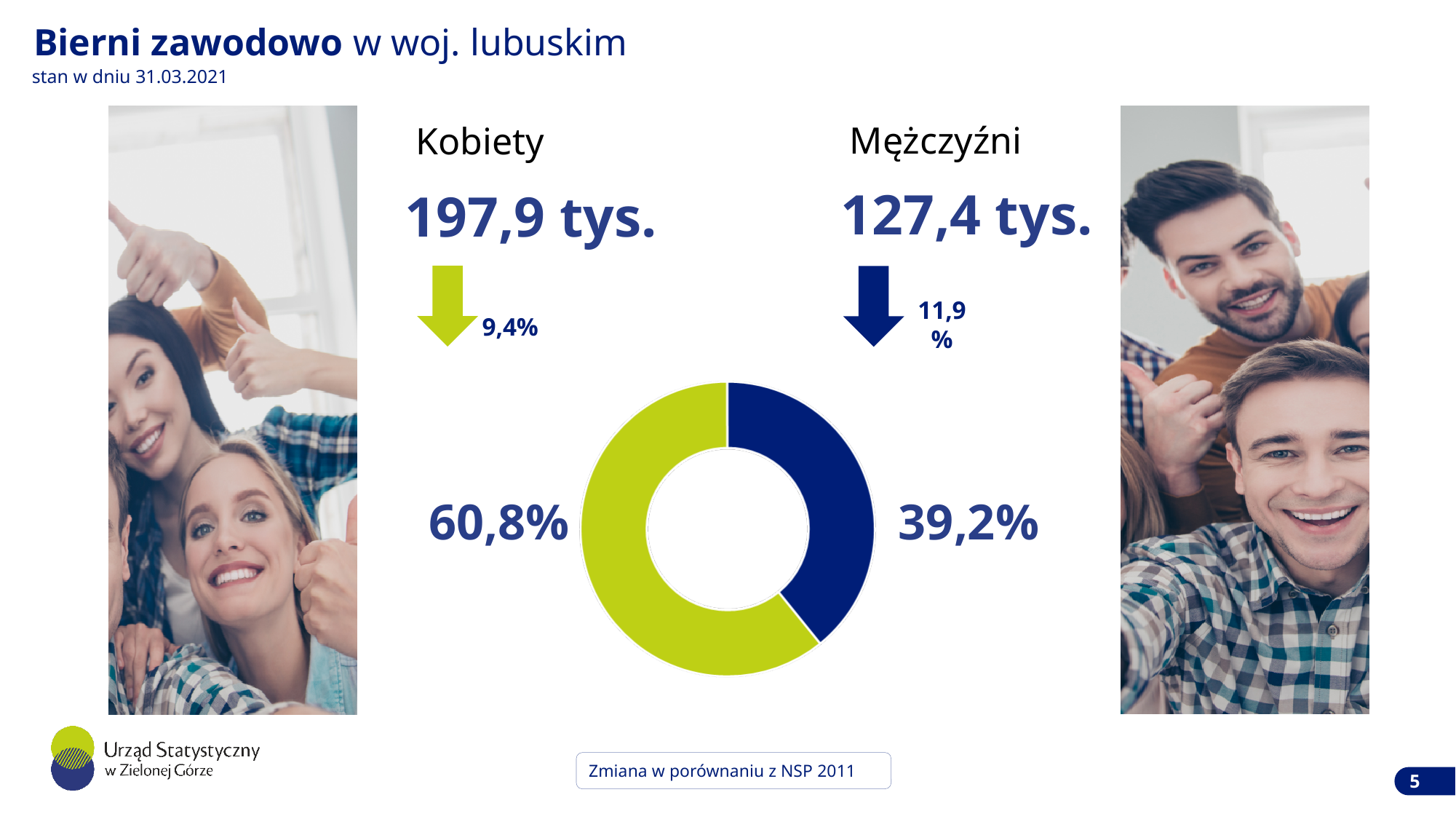
Which group has the larger slice in the donut chart, Kobiety or Mężczyźni? Kobiety What share of the donut chart does the Mężczyźni slice represent? 39,2% What share of the donut chart does the Kobiety slice represent? 60,8% What is the difference in percentage points between the Kobiety and Mężczyźni slices? 21,6 Which group has the smaller slice in the donut chart? Mężczyźni What is the difference between the Kobiety and Mężczyźni values in thousands? 70,5 tys. What is the value shown for Mężczyźni in thousands? 127,4 tys. Is the Kobiety share of the donut chart greater or less than 50%? greater What kind of chart is shown on the slide? Donut (pie) chart How many slices does the donut chart have? 2 What is the value shown for Kobiety in thousands? 197,9 tys. Which colour represents Kobiety in the donut chart? Green (lime)